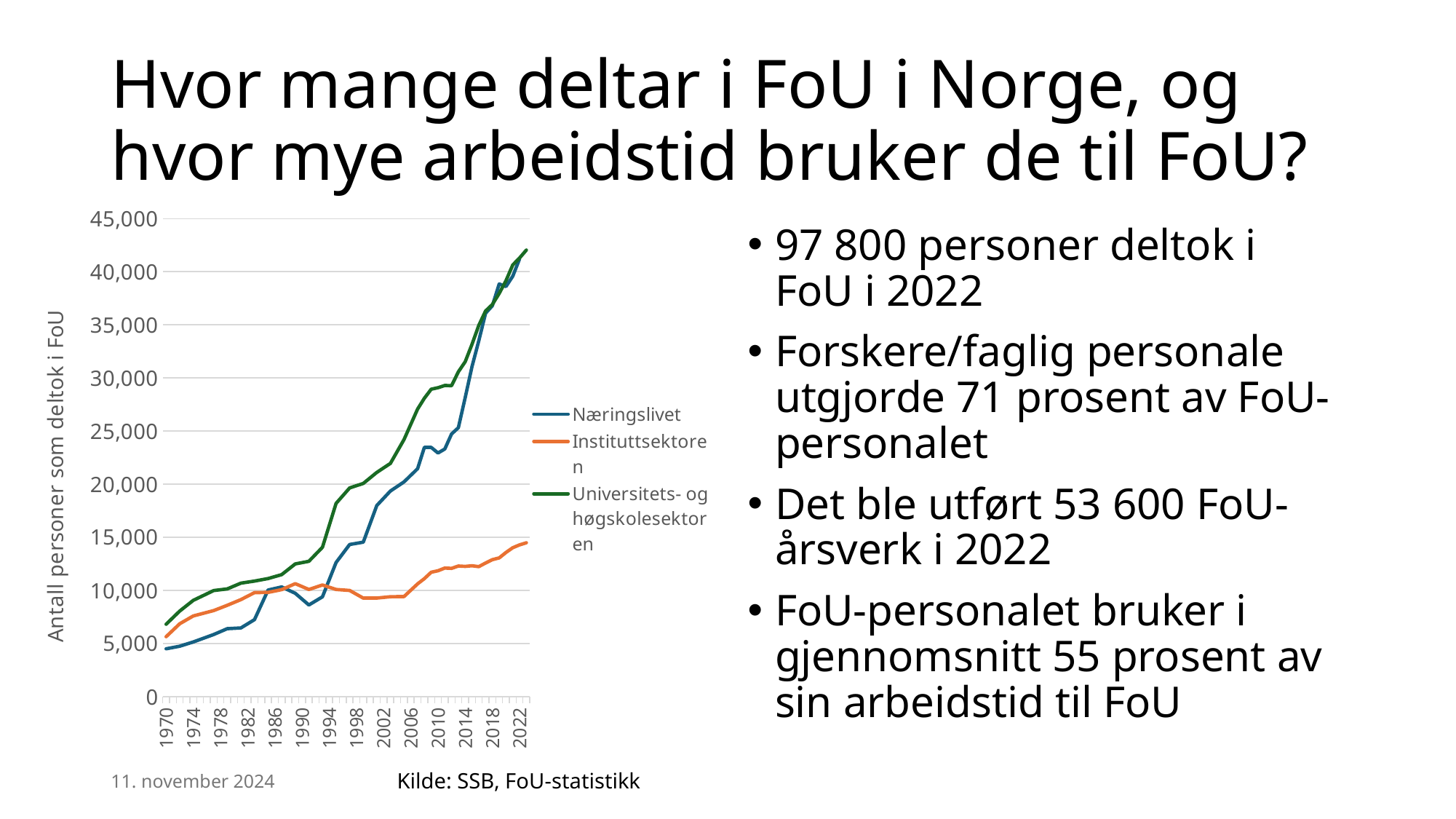
Which series is drawn in orange on the chart? Instituttsektoren In 2022, which is larger: Næringslivet or Instituttsektoren? Næringslivet Is the value for Instituttsektoren in 2022 greater or less than 20,000? less How many series does the chart's legend list? 3 What is the title of the chart's vertical axis? Antall personer som deltok i FoU Is the value for Universitets- og høgskolesektoren in 2010 greater or less than 25,000? greater Is the value for Universitets- og høgskolesektoren in 2022 greater or less than 40,000? greater What kind of chart is shown on the slide? line chart Does the Universitets- og høgskolesektoren series generally rise or fall from 1970 to 2022? rise Which series has the lowest value in 2022? Instituttsektoren In 1970, which is larger: Universitets- og høgskolesektoren or Næringslivet? Universitets- og høgskolesektoren